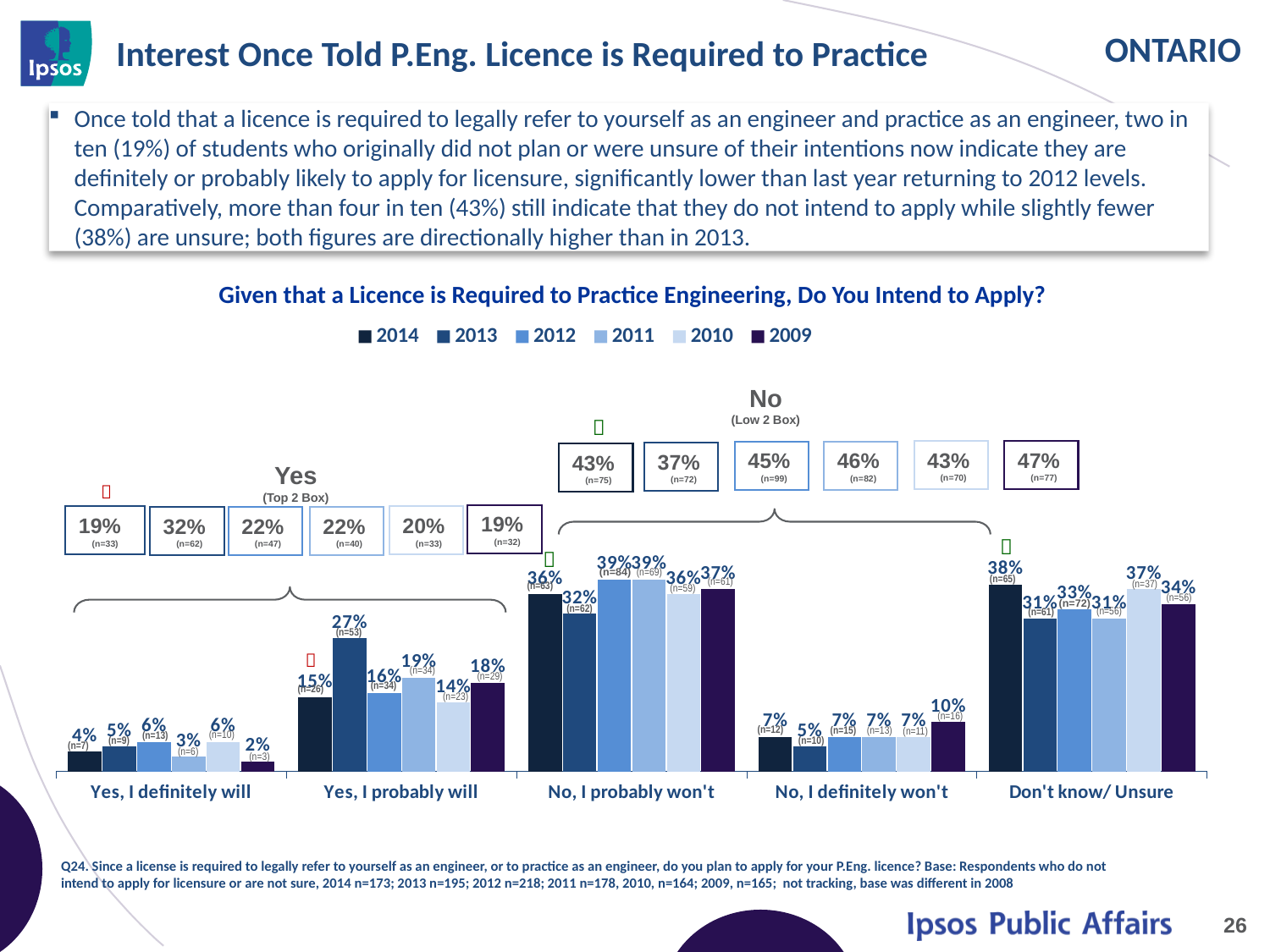
What is the 2014 "No (Low 2 Box)" value shown above the chart? 43% Which year has the lowest value for "Yes, I definitely will"? 2009 Which year has the highest value for "Yes, I probably will"? 2013 What is the title of the chart? Given that a Licence is Required to Practice Engineering, Do You Intend to Apply? What is the 2014 value for "Yes, I probably will"? 15% How many response categories are shown along the x axis of the chart? 5 How many series does the chart legend list? 6 What type of chart is shown on the slide? bar chart What is the difference between the 2013 and 2014 values for "Yes, I probably will"? 12% Which is larger for "Don't know/ Unsure": the 2014 value or the 2013 value? 2014 What is the 2013 value for "Don't know/ Unsure"? 31% What is the 2009 value for "No, I definitely won't"? 10%